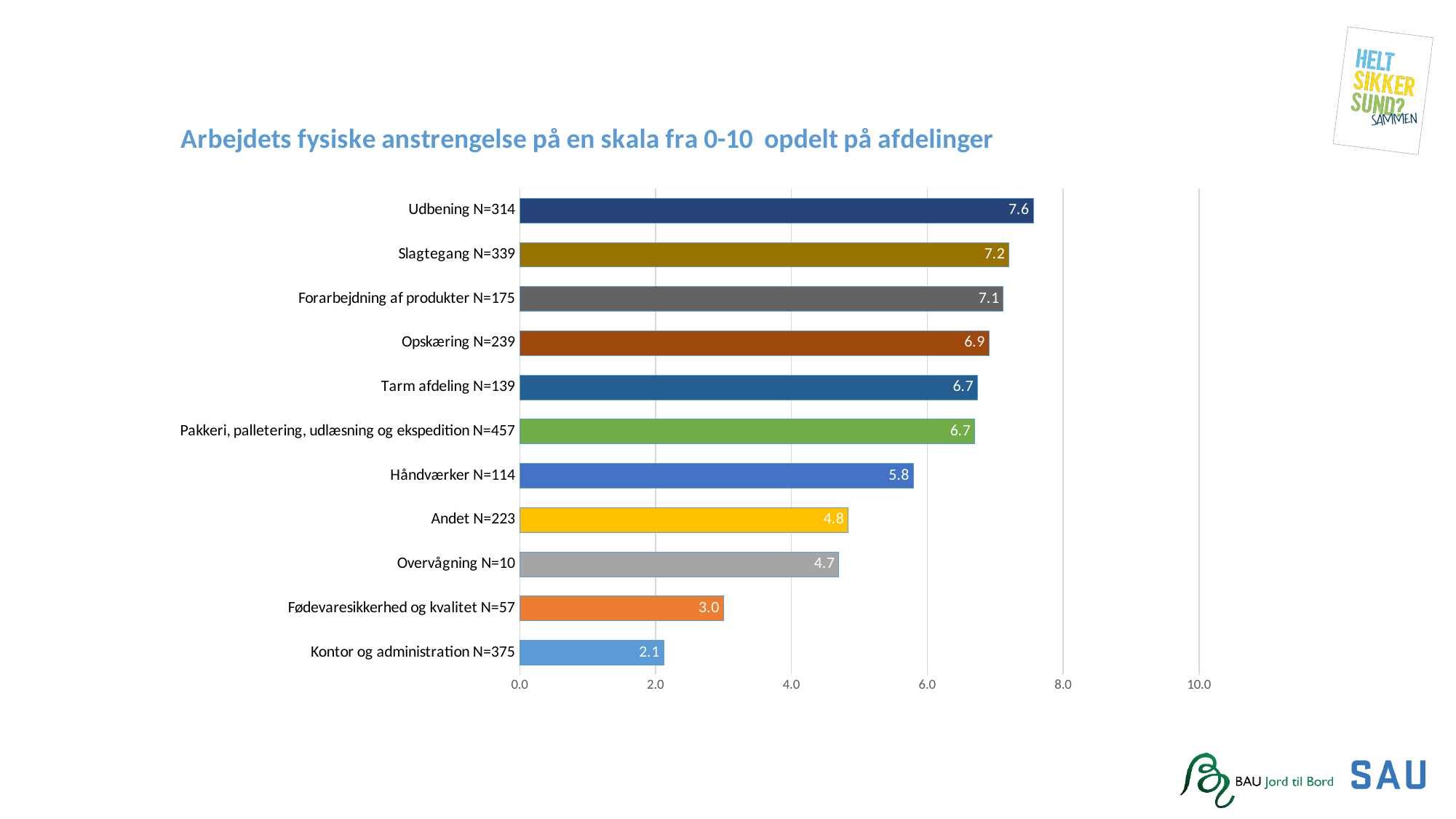
Which has a larger value, Slagtegang N=339 or Opskæring N=239? Slagtegang N=339 What kind of chart is shown on the slide? Bar chart What is the value for Kontor og administration N=375? 2.1 What is the value for Udbening N=314? 7.6 Which category has the highest value? Udbening N=314 What is the value for Andet N=223? 4.8 What is the title of the chart? Arbejdets fysiske anstrengelse på en skala fra 0-10 opdelt på afdelinger What is the difference between the values for Udbening N=314 and Kontor og administration N=375? 5.5 What is the difference between the values for Håndværker N=114 and Fødevaresikkerhed og kvalitet N=57? 2.8 How many categories are shown in the chart? 11 Which category has the lowest value? Kontor og administration N=375 Is the value for Tarm afdeling N=139 greater or less than 6.0? greater